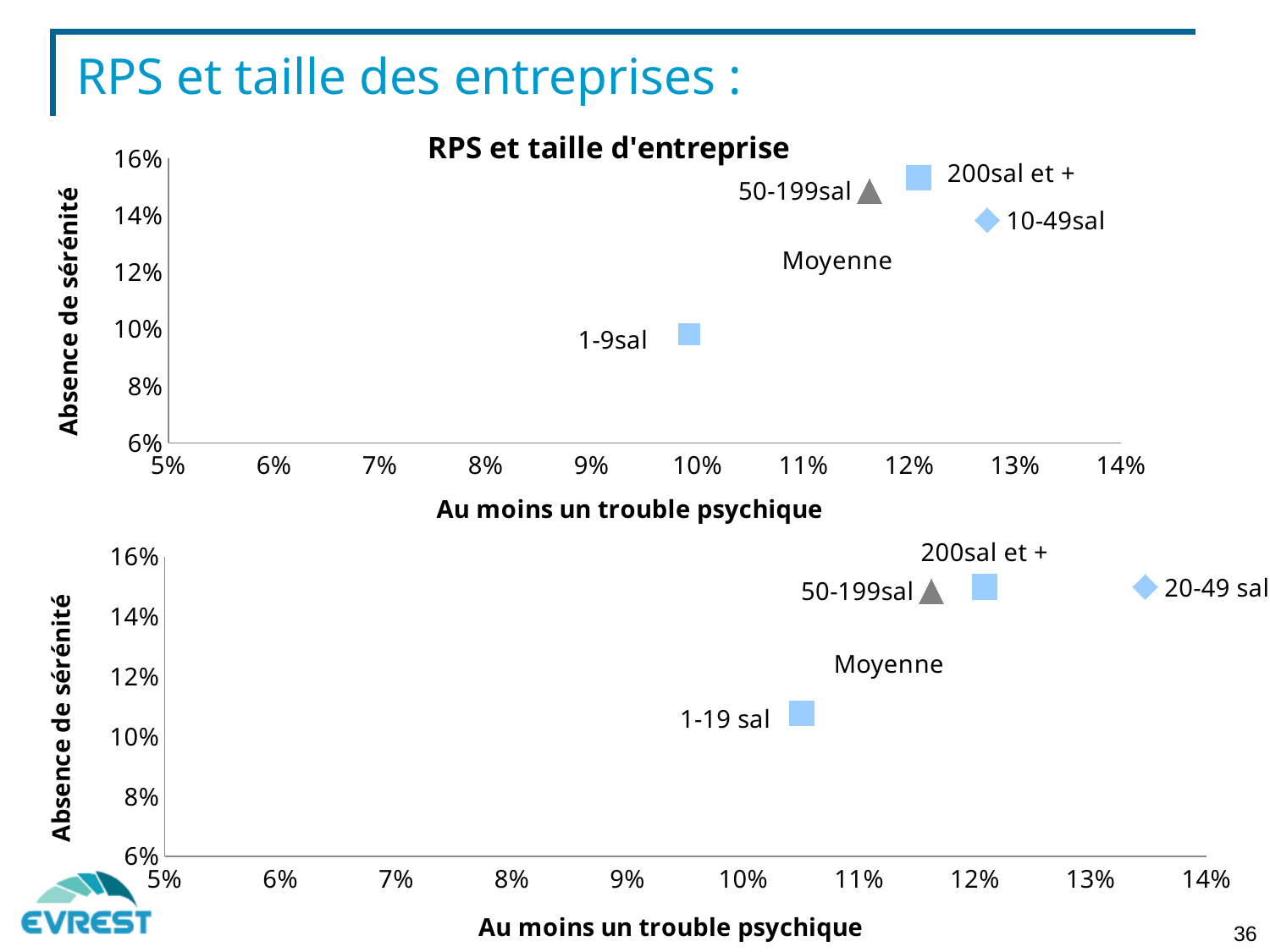
In the top chart (RPS et taille d'entreprise), is the Absence de sérénité value for 10-49sal greater or less than 12%? greater In the top chart (RPS et taille d'entreprise), which company-size category has the lowest value for Absence de sérénité? 1-9sal In the bottom chart, which company-size category has the highest value for Au moins un trouble psychique? 20-49 sal What kind of chart is the top chart on the slide? scatter chart What is the title of the top chart? RPS et taille d'entreprise In the bottom chart, which has a higher Au moins un trouble psychique value, 1-19 sal or 50-199sal? 50-199sal In the top chart (RPS et taille d'entreprise), is the Au moins un trouble psychique value for 1-9sal greater or less than 11%? less In the top chart (RPS et taille d'entreprise), which has a higher Absence de sérénité value, 1-9sal or 200sal et +? 200sal et + In the bottom chart, is the Absence de sérénité value for 1-19 sal greater or less than 12%? less In the top chart (RPS et taille d'entreprise), which company-size category has the highest value for Absence de sérénité? 200sal et + In the top chart (RPS et taille d'entreprise), which company-size category has the highest value for Au moins un trouble psychique? 10-49sal In the bottom chart, which company-size category has the lowest value for Absence de sérénité? 1-19 sal